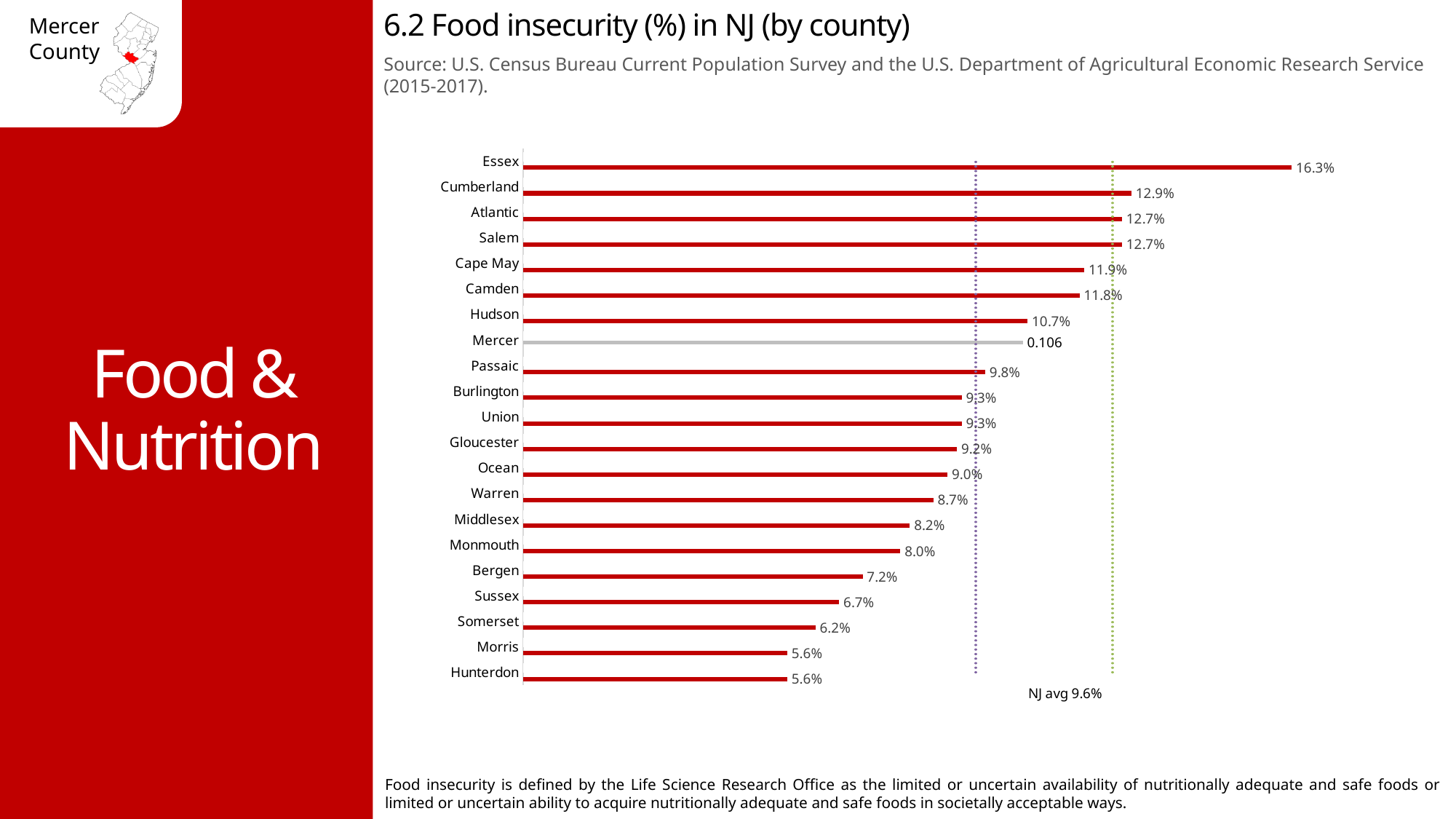
What is the food insecurity value shown for Bergen county? 7.2% Which county has the highest food insecurity value on the chart? Essex What is the food insecurity value shown for Camden county? 11.8% What value is labeled on the bar for Mercer county? 0.106 What is the difference in percentage points between Essex (16.3%) and Cumberland (12.9%)? 3.4 How many counties are plotted on the chart? 21 What is the food insecurity value shown for Essex county? 16.3% What kind of chart is used to show food insecurity by county? Bar chart Which county has a higher food insecurity value, Sussex or Somerset? Sussex What is the difference in percentage points between Camden (11.8%) and Hudson (10.7%)? 1.1 Which county has a higher food insecurity value, Passaic or Warren? Passaic What NJ average value is noted on the chart? 9.6%